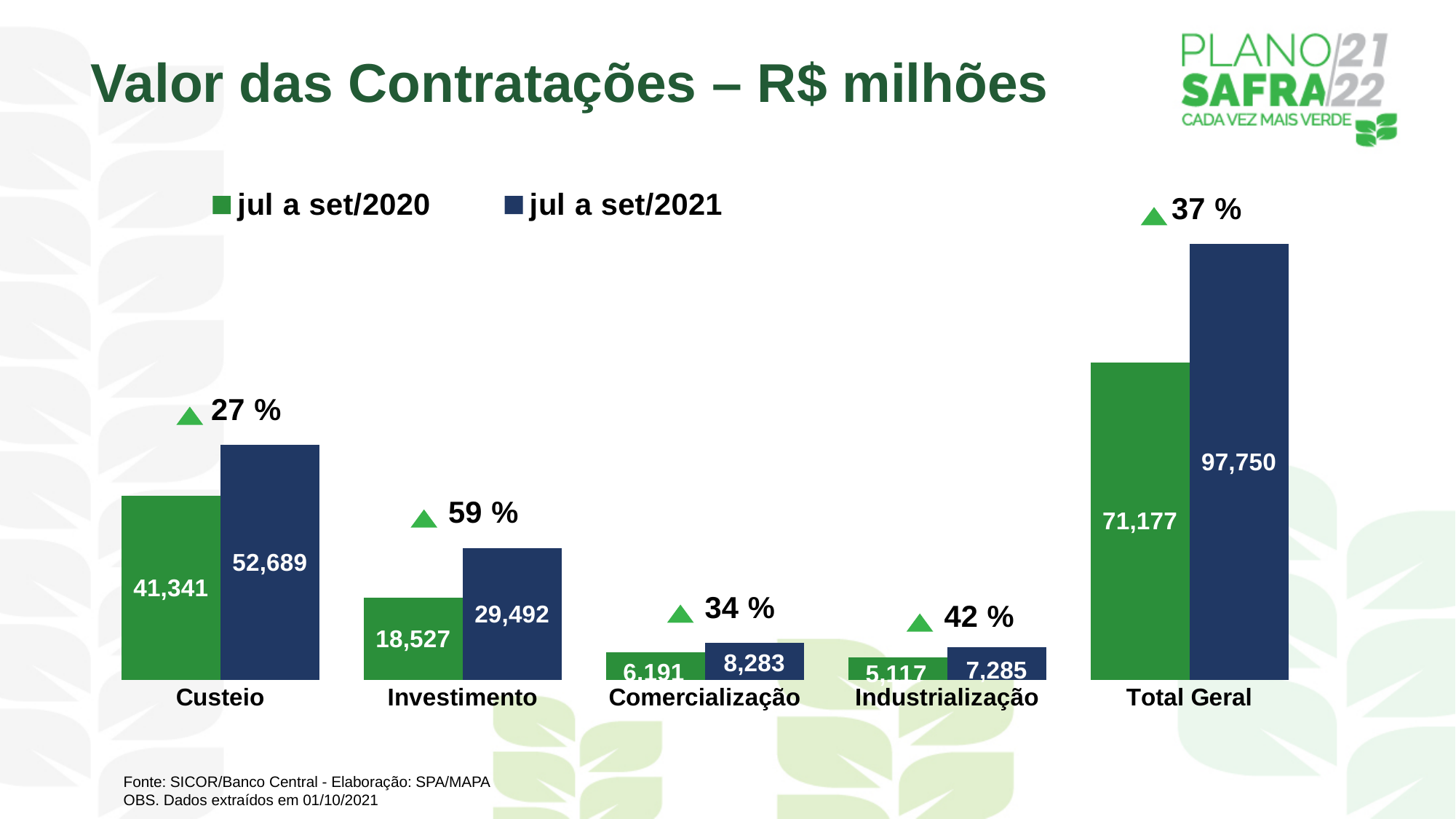
Excluding Total Geral, which category has the lowest value in the jul a set/2020 series? Industrialização What is the difference between the jul a set/2021 and jul a set/2020 values for Custeio? 11,348 Which is larger: the jul a set/2020 value for Investimento or the jul a set/2021 value for Comercialização? jul a set/2020 value for Investimento What is the value for Custeio in the jul a set/2021 series? 52,689 What is the difference between the jul a set/2021 and jul a set/2020 values for Total Geral? 26,573 What is the value for Comercialização in the jul a set/2021 series? 8,283 What percentage increase is shown above the Investimento bars? 59 % What is the value for Industrialização in the jul a set/2020 series? 5,117 Excluding Total Geral, which category has the highest value in the jul a set/2021 series? Custeio What is the value for Total Geral in the jul a set/2021 series? 97,750 What is the value for Investimento in the jul a set/2020 series? 18,527 How many series does the legend list? 2